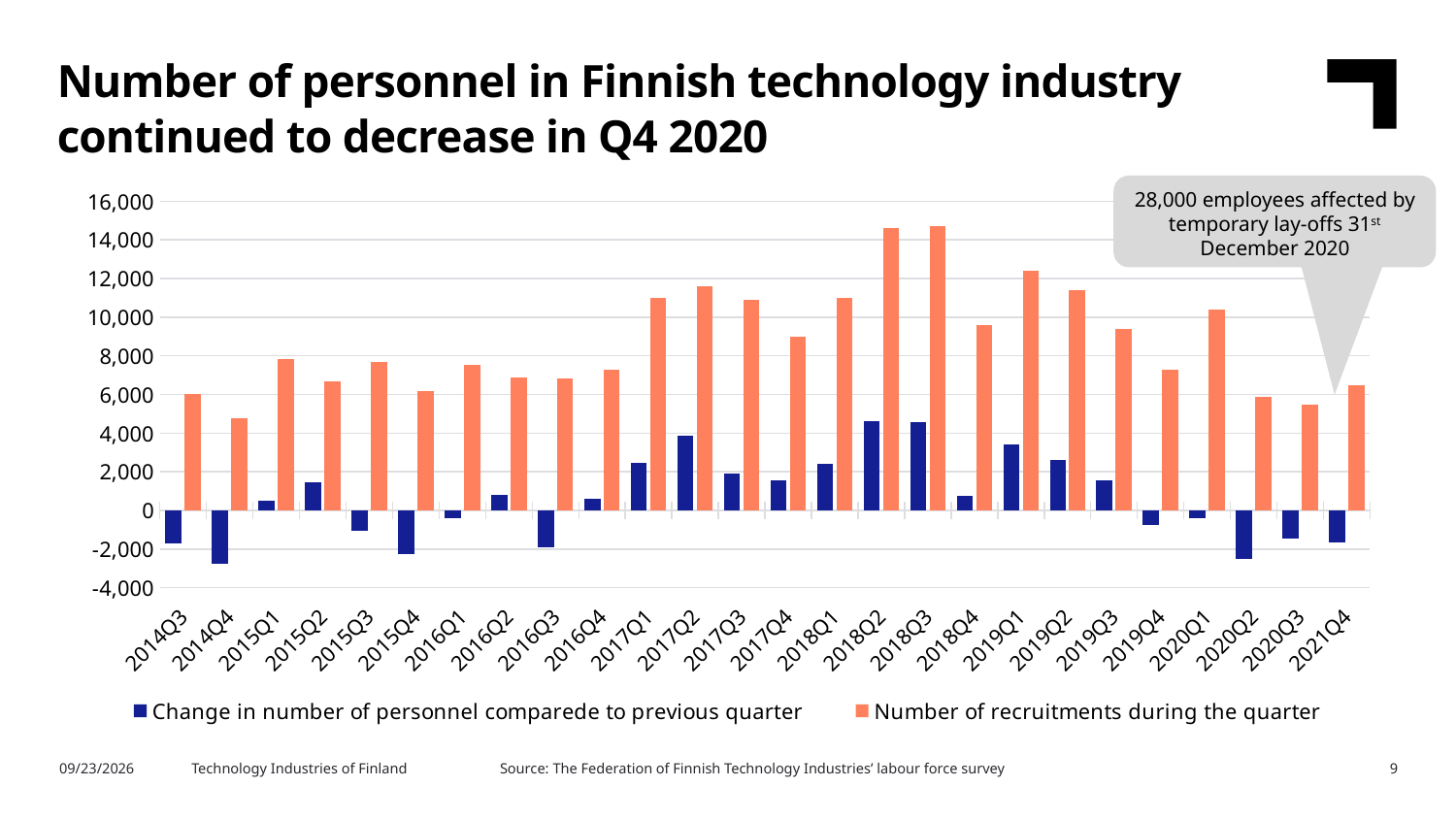
What kind of chart is shown on the slide? Bar chart According to the callout on the chart, how many employees were affected by temporary lay-offs on 31st December 2020? 28,000 Is the number of recruitments during the quarter for 2020Q3 greater or less than 6,000? less Is the change in number of personnel compared to previous quarter for 2017Q2 greater or less than 2,000? greater Which quarter has more recruitments during the quarter, 2017Q2 or 2016Q2? 2017Q2 Is the number of recruitments during the quarter for 2018Q2 greater or less than 14,000? greater How many quarters are shown on the x axis? 26 How many series does the legend list? 2 Which quarter has a larger change in number of personnel compared to previous quarter, 2018Q2 or 2019Q1? 2018Q2 Which quarter has the lowest number of recruitments during the quarter? 2014Q4 Do the number of recruitments during the quarter rise or fall from 2019Q1 to 2019Q4? fall